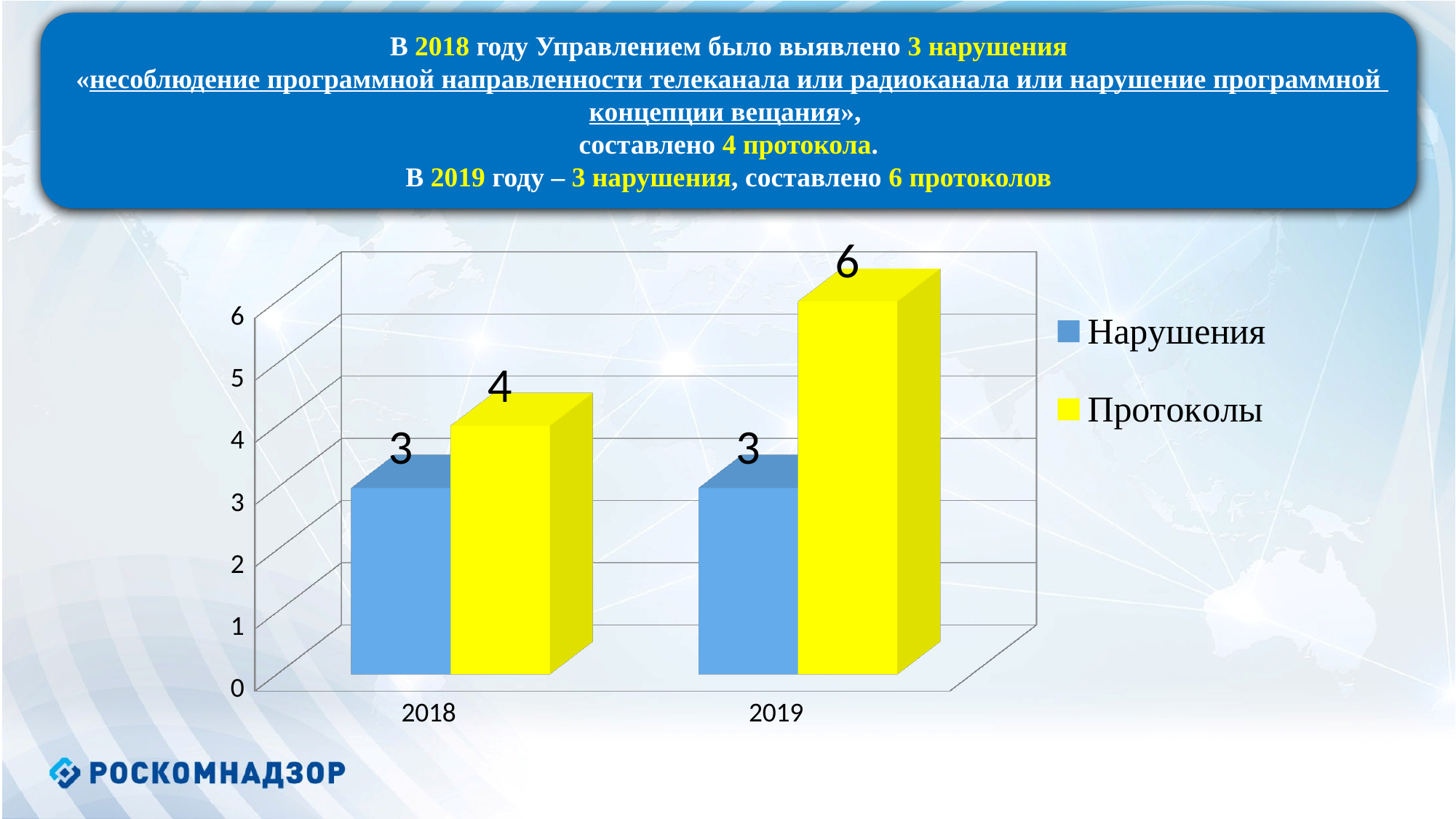
How many series does the legend list? 2 How many years are shown on the x axis? 2 What is the value of Протоколы for 2019? 6 What is the value of Нарушения for 2019? 3 What kind of chart is shown on the slide? bar chart In which year is the value of Протоколы highest? 2019 Which is larger in 2018: Нарушения or Протоколы? Протоколы What is the value of Протоколы for 2018? 4 What is the value of Нарушения for 2018? 3 What is the difference between Протоколы in 2019 and Протоколы in 2018? 2 What is the difference between Протоколы and Нарушения in 2019? 3 Does the value of Протоколы rise or fall from 2018 to 2019? rise